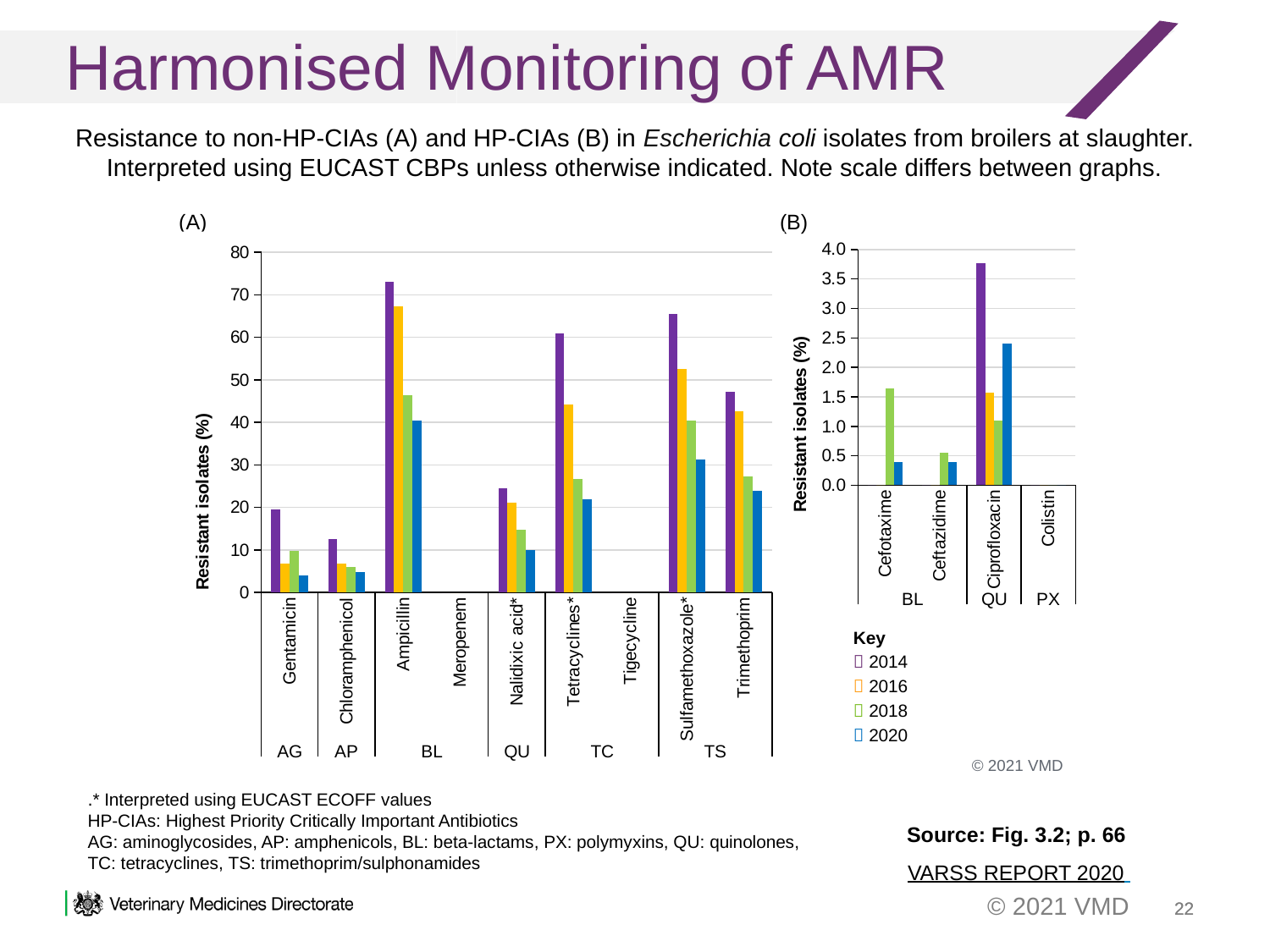
How many antibiotics are shown on the x axis of chart (B)? 4 In chart (B), is the 2014 value for Ciprofloxacin greater or less than 3.5? greater In chart (A), is the 2014 value for Ampicillin greater or less than 70? greater In chart (B), is the 2020 value for Ciprofloxacin greater or less than 2.0? greater What kind of chart is chart (A)? bar chart How many antibiotics are shown on the x axis of chart (A)? 9 In chart (B), which antibiotic has the highest 2014 resistance value? Ciprofloxacin In chart (A), which antibiotic has the highest 2014 resistance value? Ampicillin In chart (A), which is larger: the 2014 value for Ampicillin or the 2014 value for Sulfamethoxazole*? Ampicillin In chart (A), does the resistance for Ampicillin rise or fall from 2014 to 2020? fall How many years does the key list for the charts? 4